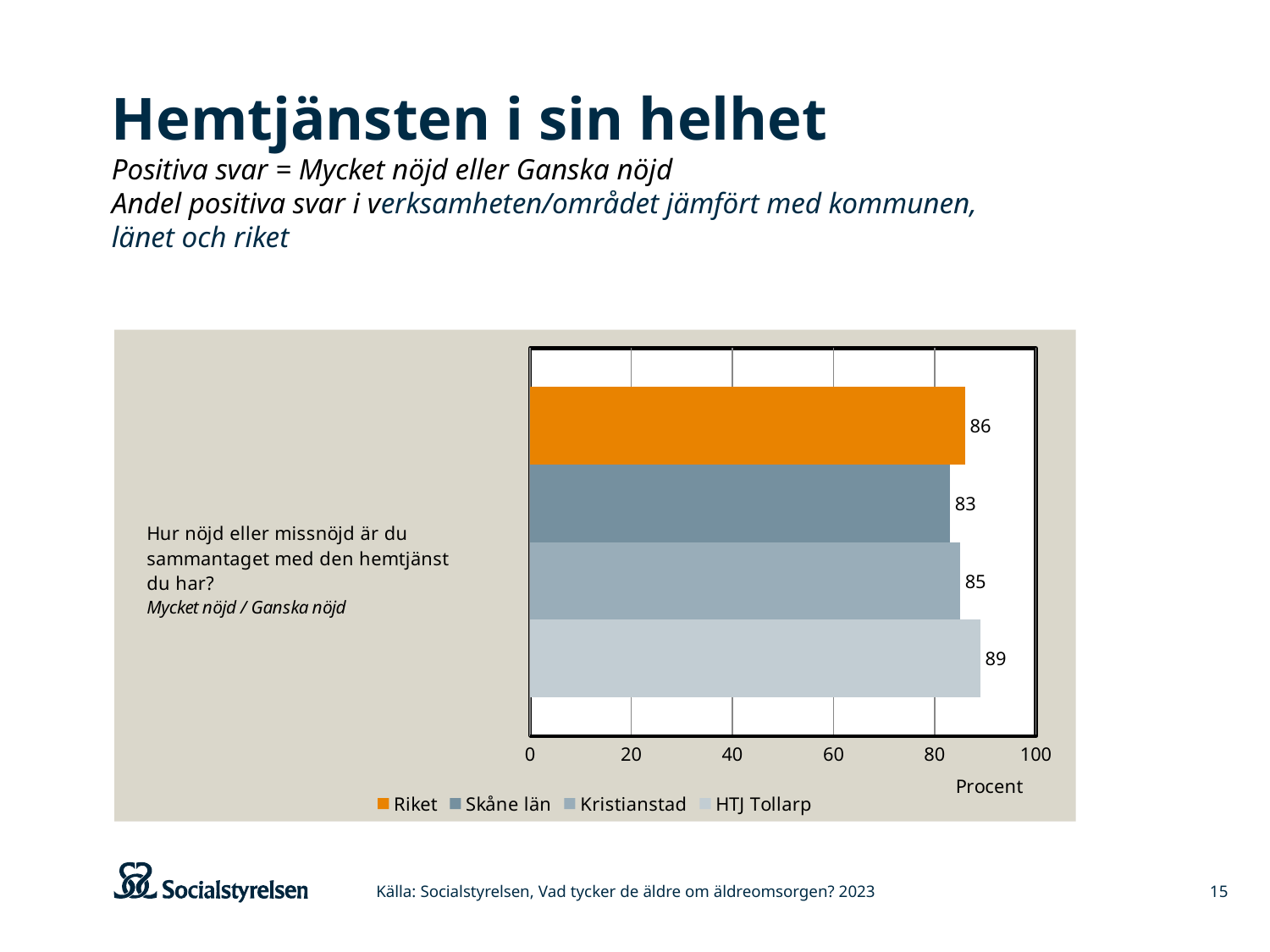
Which is larger, the value for HTJ Tollarp or the value for Riket? HTJ Tollarp Which series has the lowest value? Skåne län What is the value for Riket? 86 Which series has the highest value? HTJ Tollarp What is the difference between the values for Riket and Kristianstad? 1 What is the value for HTJ Tollarp? 89 What kind of chart is shown on the slide? Bar chart How many series does the legend list? 4 What is the value for Skåne län? 83 What unit is shown on the x axis of the chart? Procent What is the difference between the values for HTJ Tollarp and Skåne län? 6 What is the value for Kristianstad? 85